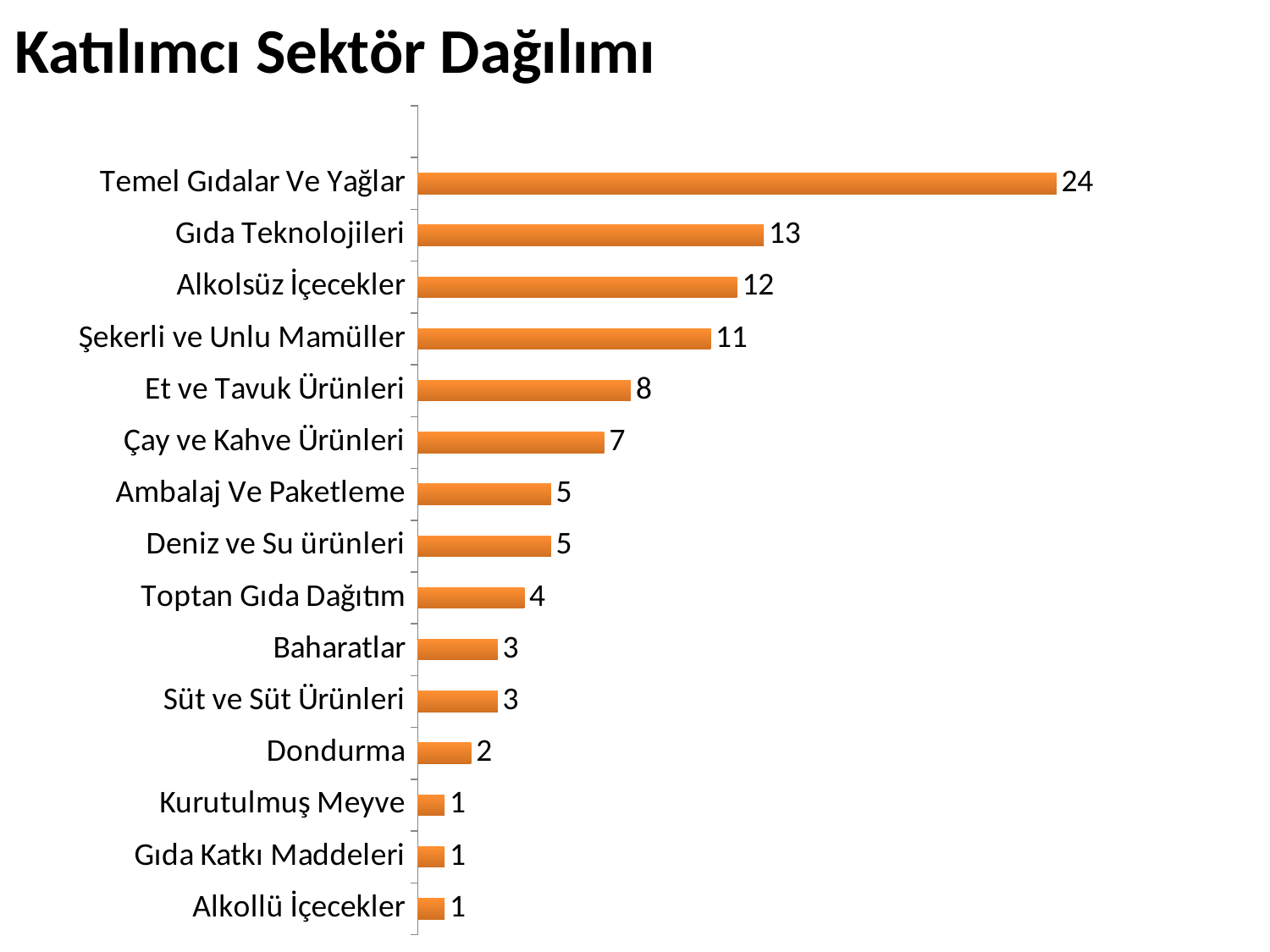
Which is larger, Dondurma or Baharatlar? Baharatlar What is the difference between Et ve Tavuk Ürünleri and Çay ve Kahve Ürünleri? 1 What is the title of the chart? Katılımcı Sektör Dağılımı Which is larger, Alkolsüz İçecekler or Şekerli ve Unlu Mamüller? Alkolsüz İçecekler What kind of chart is shown on the slide? Bar chart Which category has the highest value? Temel Gıdalar Ve Yağlar What is the value for Temel Gıdalar Ve Yağlar? 24 How many categories are shown in the chart? 15 What is the value for Şekerli ve Unlu Mamüller? 11 What is the value for Gıda Teknolojileri? 13 What is the value for Toptan Gıda Dağıtım? 4 What is the difference between Temel Gıdalar Ve Yağlar and Gıda Teknolojileri? 11